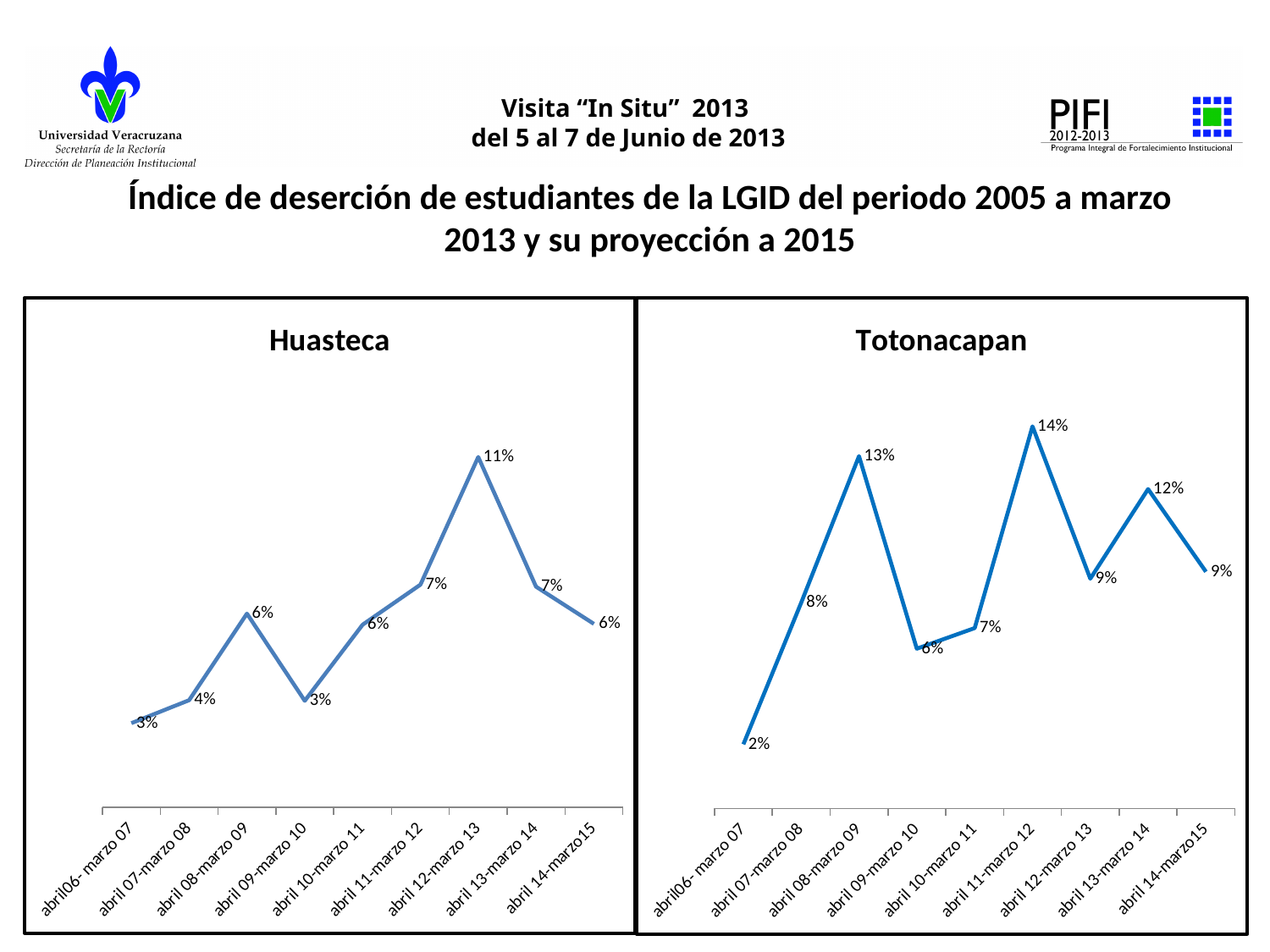
How many periods are plotted in the Huasteca chart? 9 In the Totonacapan chart, what is the value for abril 08-marzo 09? 13% In the Totonacapan chart, what is the difference between the values for abril 11-marzo 12 and abril 12-marzo 13? 5% In the Totonacapan chart, which period has the highest value? abril 11-marzo 12 In the Huasteca chart, what is the difference between the values for abril 12-marzo 13 and abril 13-marzo 14? 4% In the Huasteca chart, which period has the highest value? abril 12-marzo 13 In the Huasteca chart, what is the value for abril 14-marzo15? 6% In the Huasteca chart, what is the value for abril 12-marzo 13? 11% What type of chart is the Huasteca chart? line chart In the Totonacapan chart, which period has the lowest value? abril06- marzo 07 What is the title of the chart on the right side of the slide? Totonacapan In the Totonacapan chart, which is larger, the value for abril 08-marzo 09 or the value for abril 13-marzo 14? abril 08-marzo 09